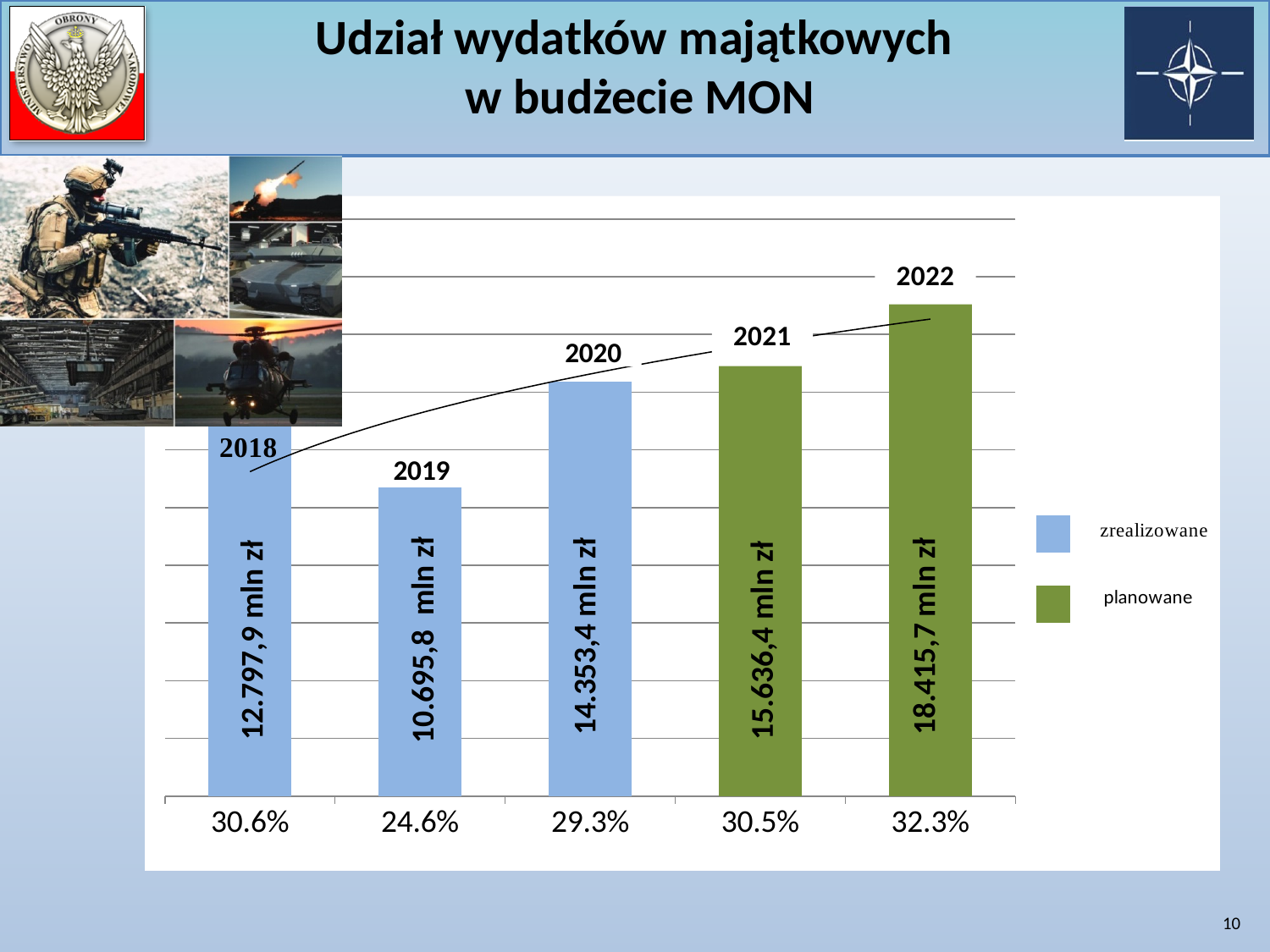
What is the value printed on the bar for 2019? 10.695,8 mln zł What percentage is shown on the x axis under the 2021 bar? 30.5% How many series does the legend list? 2 Which year has the highest bar? 2022 Which bar is taller, 2020 or 2021? 2021 Which year has the lowest bar? 2019 What is the value printed on the bar for 2022? 18.415,7 mln zł What is the value printed on the bar for 2018? 12.797,9 mln zł How many bars are shown in the chart? 5 What kind of chart is shown on the slide? bar chart What percentage is shown on the x axis under the 2020 bar? 29.3% Which legend entry corresponds to the green bars? planowane